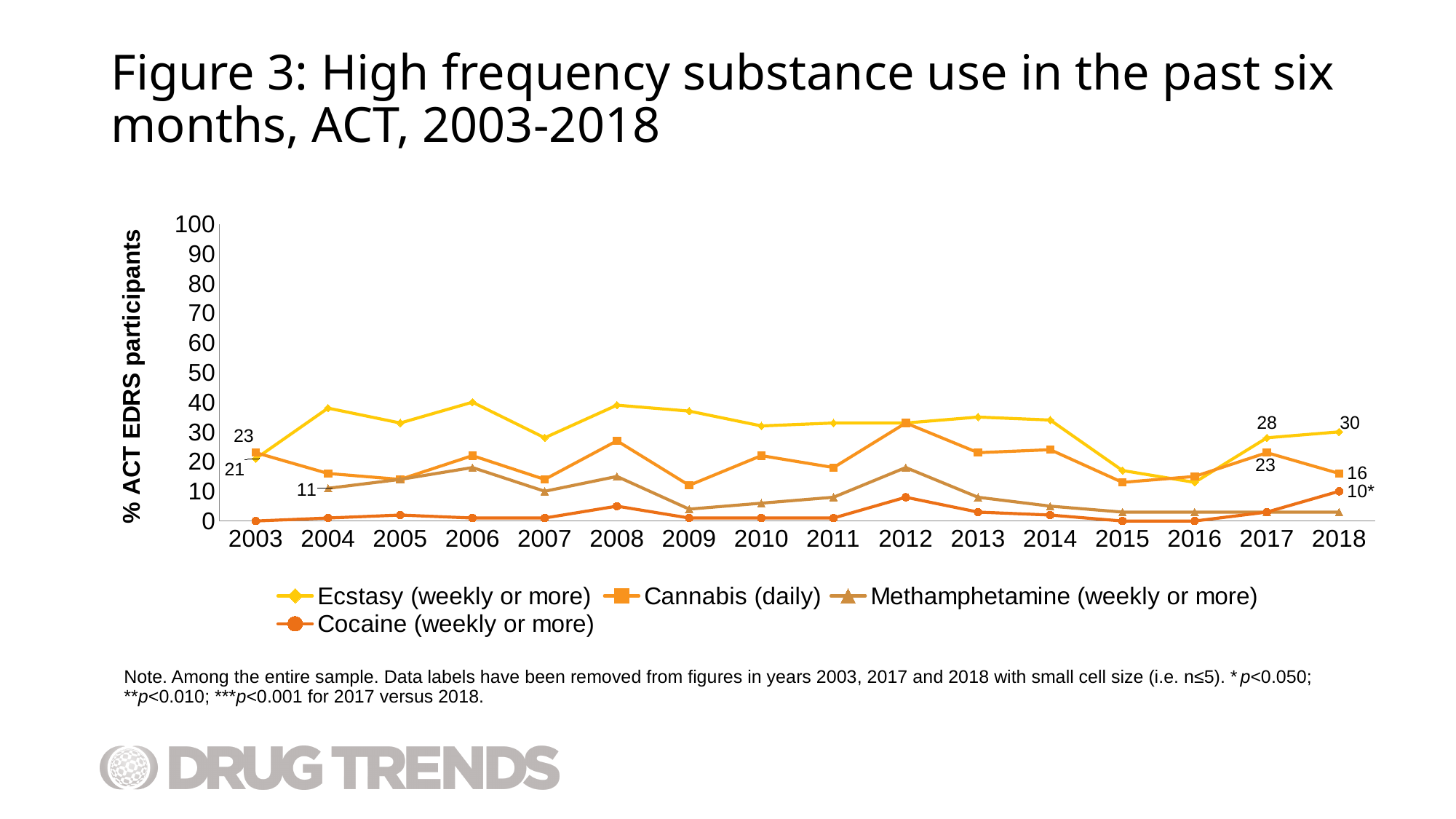
What is the value for Methamphetamine (weekly or more) in 2004? 11 Is the value for Ecstasy (weekly or more) in 2006 greater or less than 30? greater What is the value for Ecstasy (weekly or more) in 2017? 28 What kind of chart is shown on the slide? Line chart How many series does the legend list? 4 Which is larger for Ecstasy (weekly or more): the 2017 value or the 2018 value? 2018 What is the value for Cannabis (daily) in 2017? 23 How many years are plotted along the x axis? 16 What is the value for Cannabis (daily) in 2018? 16 What is the value for Ecstasy (weekly or more) in 2018? 30 What is the difference between the Ecstasy (weekly or more) and Cannabis (daily) values in 2018? 14 Which series has the highest value in 2018? Ecstasy (weekly or more)